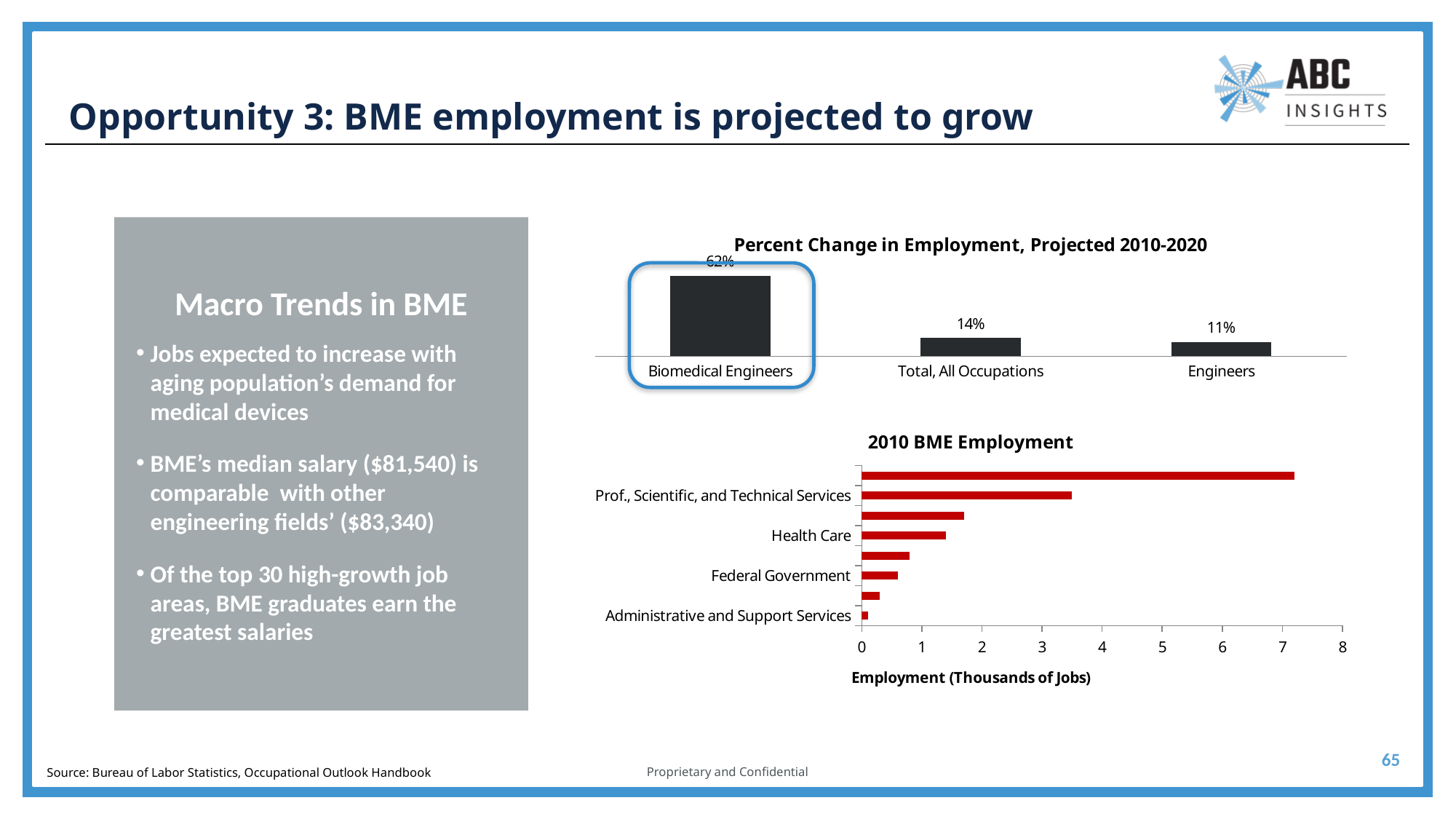
In the 'Percent Change in Employment, Projected 2010-2020' chart, which category has the highest value? Biomedical Engineers In the 'Percent Change in Employment, Projected 2010-2020' chart, which category has the lowest value? Engineers In the 'Percent Change in Employment, Projected 2010-2020' chart, what is the value for Engineers? 11% In the '2010 BME Employment' chart, is the value for Federal Government greater or less than 1? less In the 'Percent Change in Employment, Projected 2010-2020' chart, what is the value for Total, All Occupations? 14% What is the x-axis title of the '2010 BME Employment' chart? Employment (Thousands of Jobs) In the 'Percent Change in Employment, Projected 2010-2020' chart, what is the difference between the values for Biomedical Engineers and Total, All Occupations? 48% In the '2010 BME Employment' chart, is the value for Prof., Scientific, and Technical Services greater or less than 3? greater In the 'Percent Change in Employment, Projected 2010-2020' chart, how many categories are shown? 3 In the '2010 BME Employment' chart, which is larger, the value for Health Care or the value for Federal Government? Health Care What kind of chart is the '2010 BME Employment' chart? Bar chart In the 'Percent Change in Employment, Projected 2010-2020' chart, what is the value for Biomedical Engineers? 62%